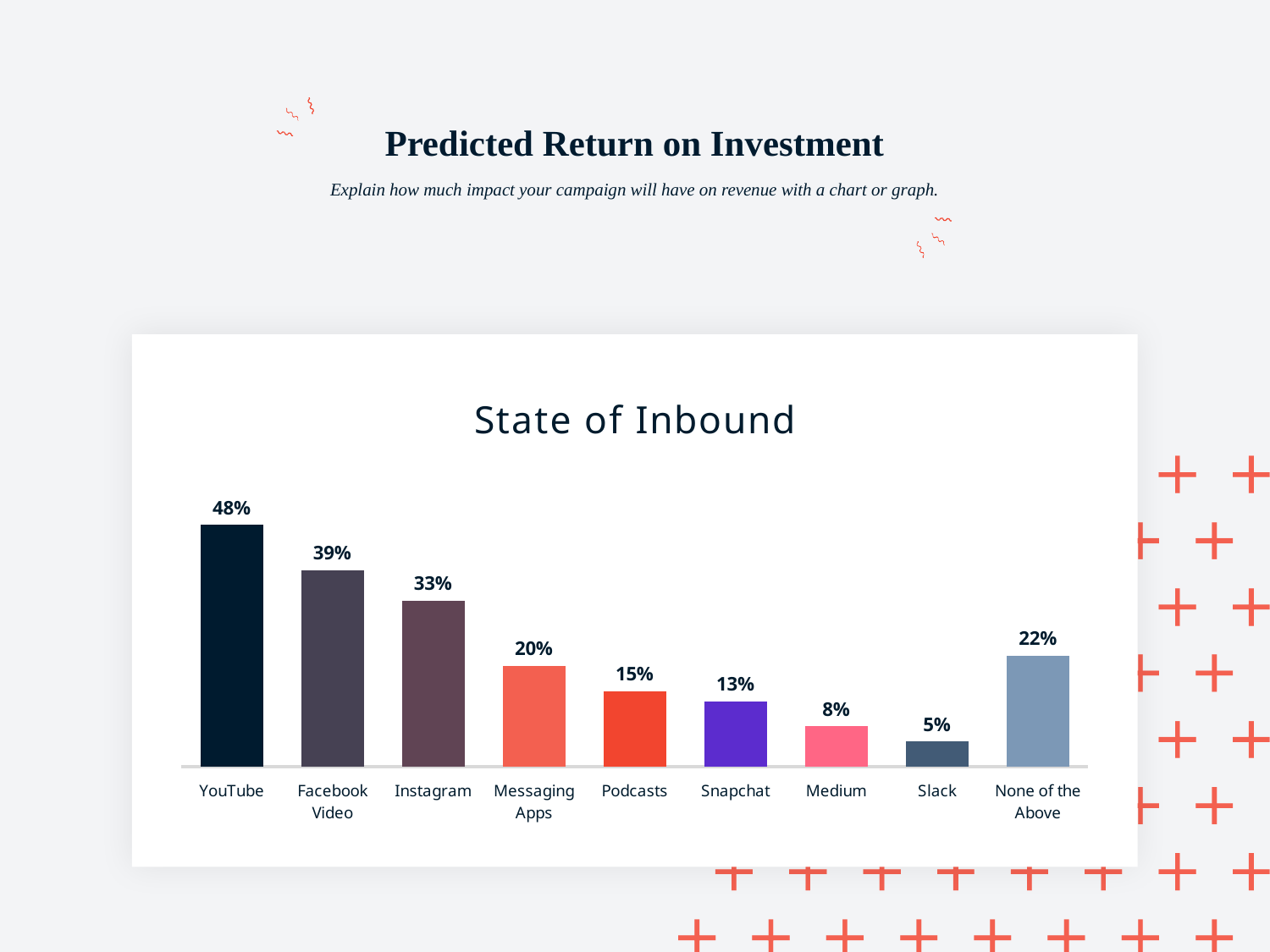
Which is larger, the value for Medium or the value for Podcasts? Podcasts How many categories are shown in the chart? 9 What is the difference between the values for YouTube and Facebook Video? 9% What is the difference between the values for Instagram and Podcasts? 18% Which category has the highest value? YouTube Which is larger, the value for Snapchat or the value for None of the Above? None of the Above What is the value for Messaging Apps? 20% What is the value for YouTube? 48% What is the title of the chart? State of Inbound What kind of chart is shown on the slide? Bar chart Which category has the lowest value? Slack What is the value for None of the Above? 22%